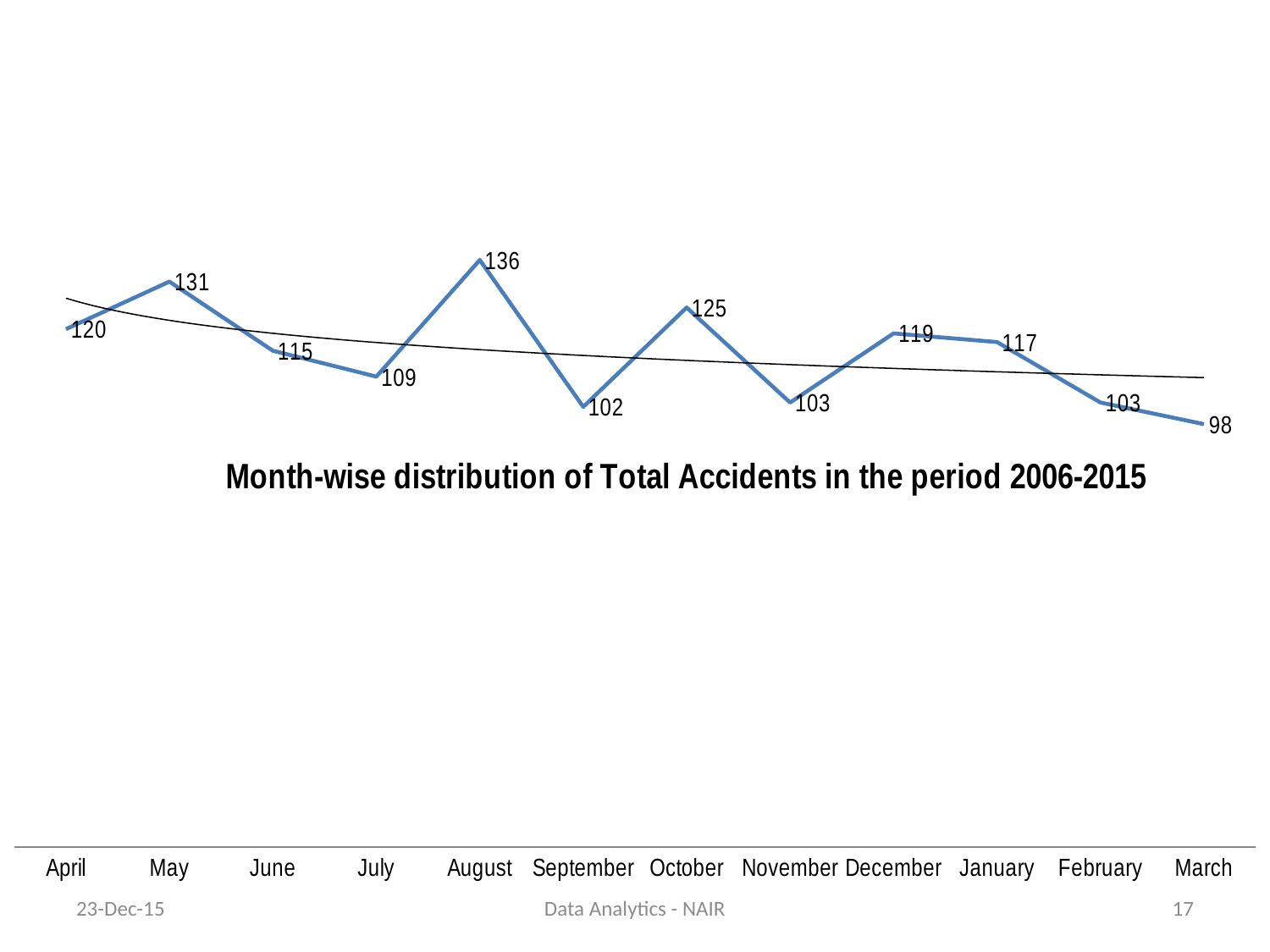
What is the value for March? 98 Which month has the highest value? August How many months are plotted on the chart? 12 Which month has the lowest value? March What is the difference between the values for August and September? 34 Which is larger, the value for October or the value for November? October What is the title of the chart? Month-wise distribution of Total Accidents in the period 2006-2015 What is the value for August? 136 Does the value fall or rise from February to March? Fall What kind of chart is shown on the slide? Line chart What is the value for December? 119 What is the difference between the values for May and April? 11